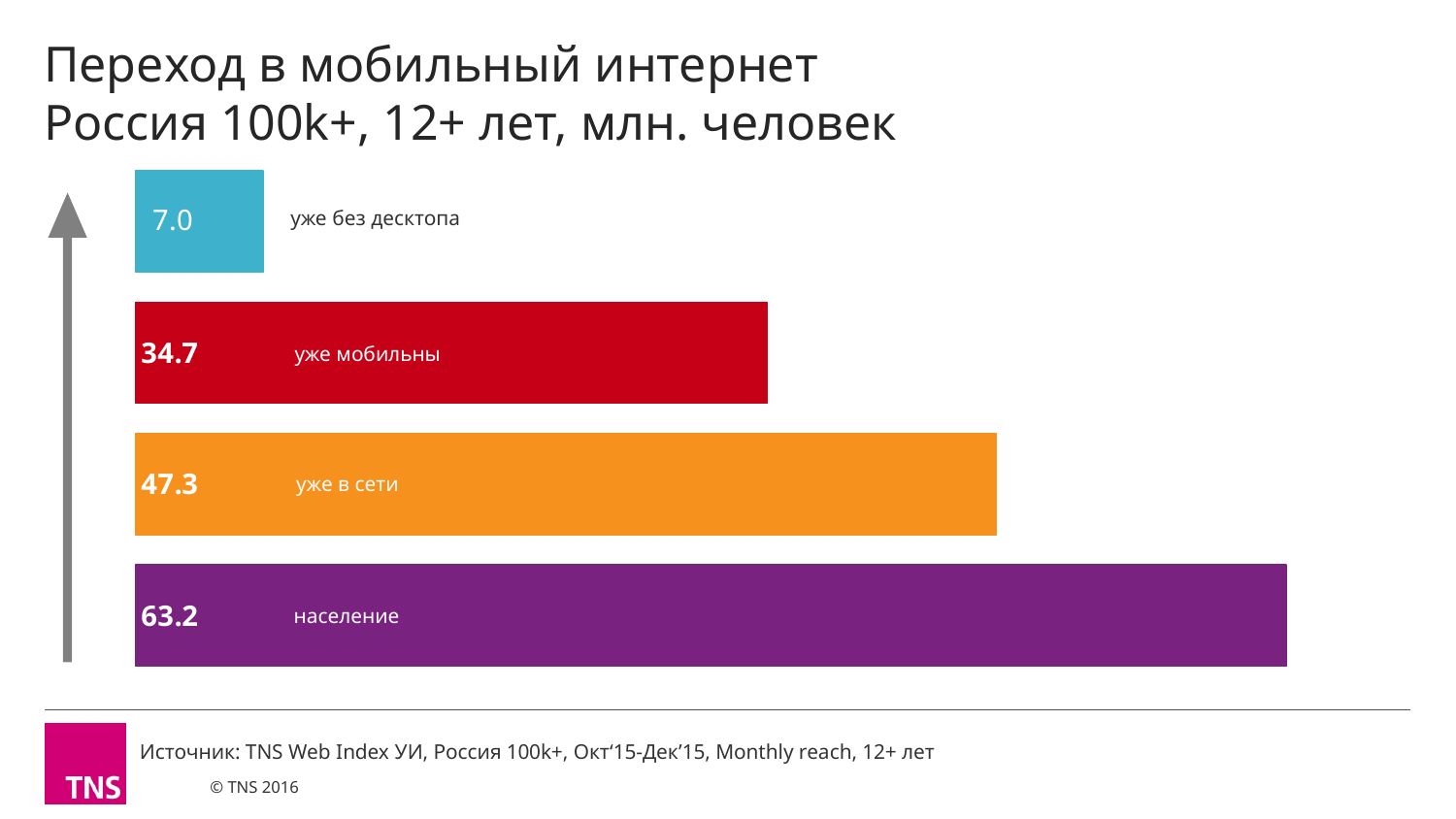
What kind of chart is shown on the slide? bar chart What is the value for "уже без десктопа"? 7.0 Which is larger, "уже мобильны" or "уже без десктопа"? уже мобильны Which category has the highest value? население What is the difference between "уже в сети" and "уже мобильны"? 12.6 What is the value for "уже в сети"? 47.3 What is the difference between "население" and "уже в сети"? 15.9 What is the value for "уже мобильны"? 34.7 Which category has the lowest value? уже без десктопа How many categories are shown in the chart? 4 What colour is the bar for "уже в сети"? orange What is the value for "население"? 63.2